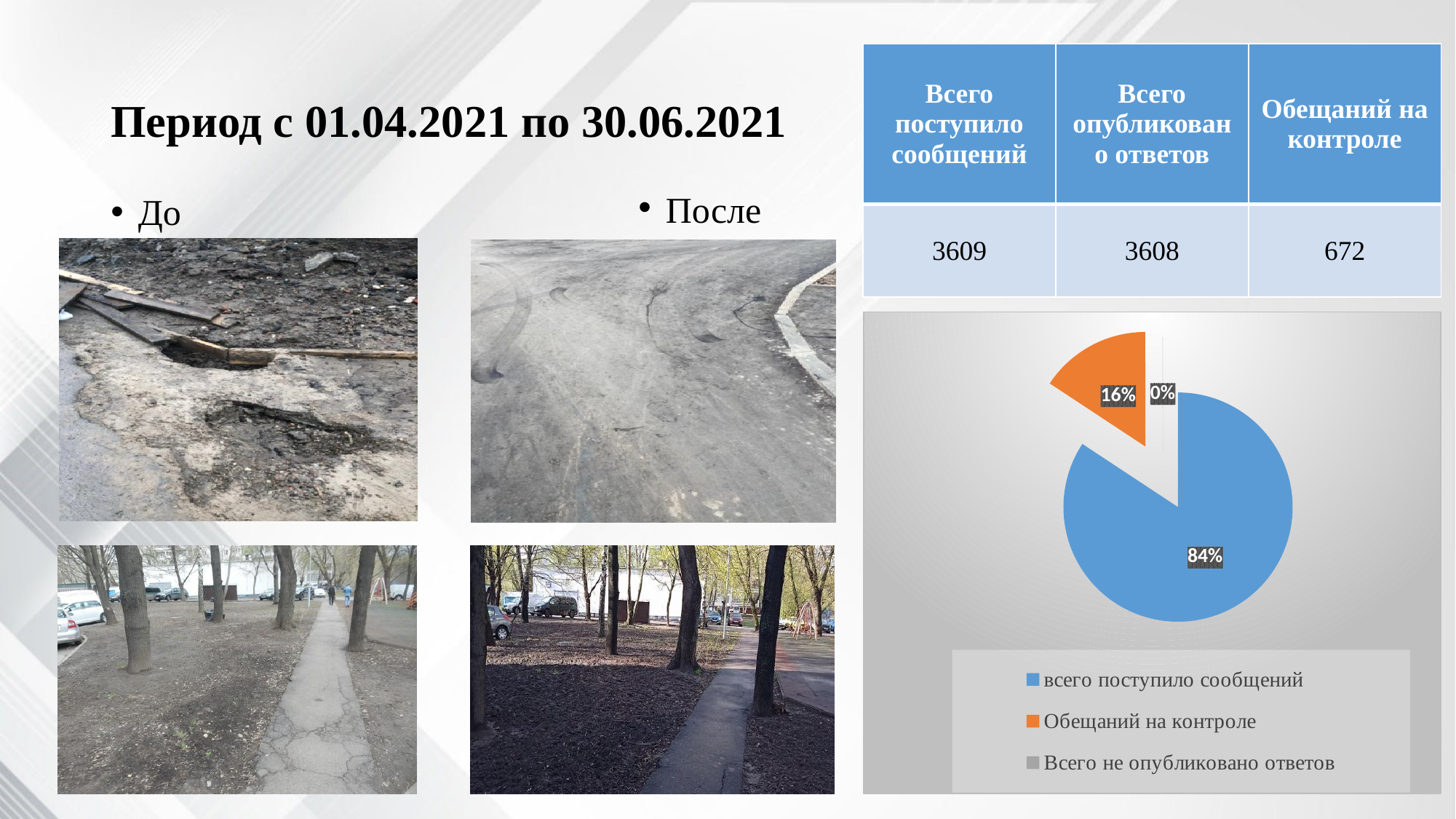
Which category has the largest slice in the pie chart? всего поступило сообщений In the pie chart, which is larger: the slice for "Обещаний на контроле" or the slice for "Всего не опубликовано ответов"? Обещаний на контроле What share of the pie chart does "Обещаний на контроле" take? 16% What kind of chart is shown on the right side of the slide? pie chart What share of the pie chart does "Всего не опубликовано ответов" take? 0% How many slices are labelled in the pie chart? 3 Which category has the smallest slice in the pie chart? Всего не опубликовано ответов What colour is the slice for "Обещаний на контроле" in the pie chart? orange In the pie chart, what is the difference in percentage points between "всего поступило сообщений" and "Обещаний на контроле"? 68 What share of the pie chart does "всего поступило сообщений" take? 84% What colour is the slice for "всего поступило сообщений" in the pie chart? blue How many entries does the legend of the pie chart list? 3